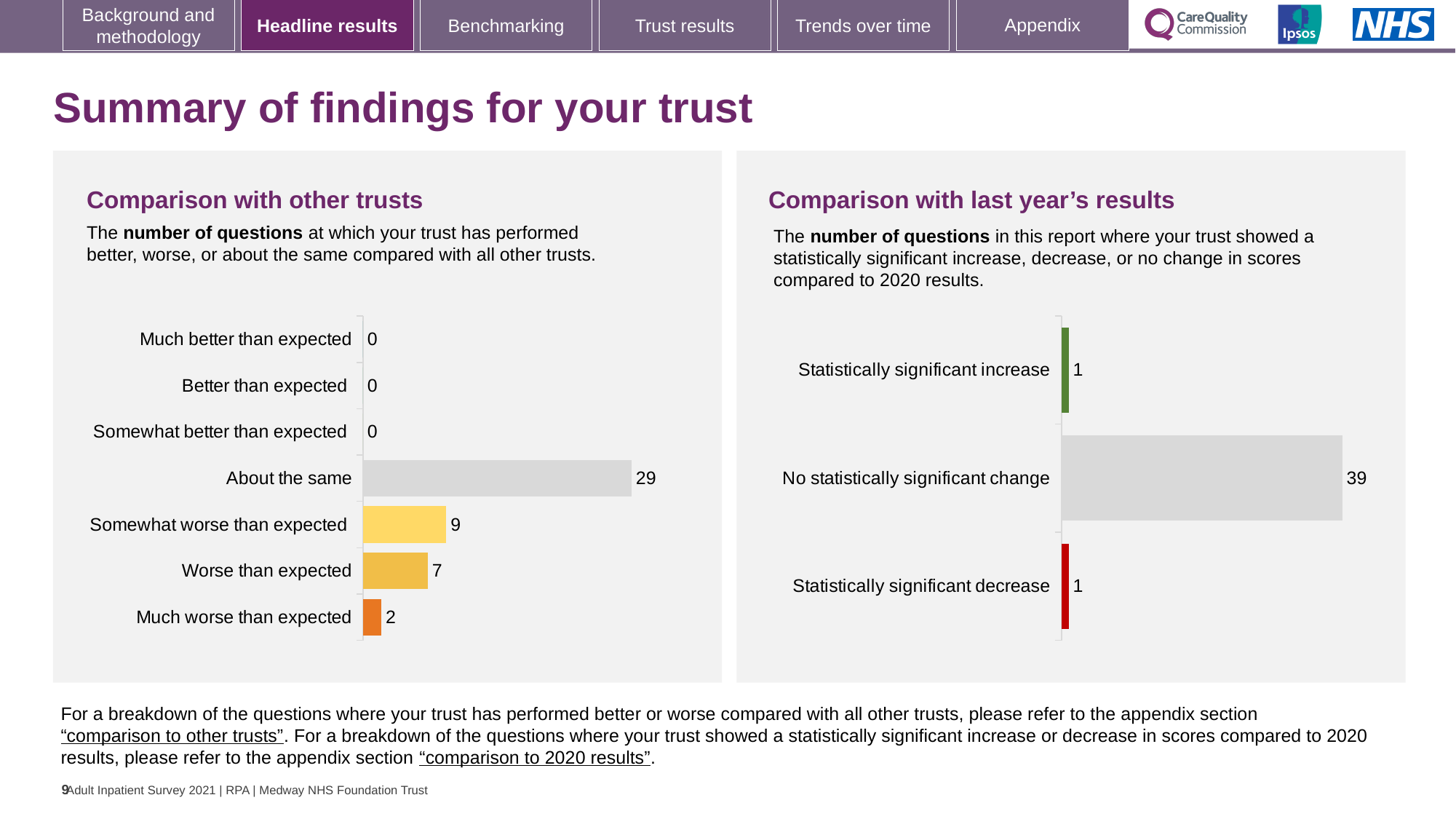
In the 'Comparison with other trusts' chart, how many questions are 'About the same'? 29 In the 'Comparison with last year's results' chart, what colour is the bar for 'Statistically significant decrease'? Red In the 'Comparison with other trusts' chart, what is the value for 'Much worse than expected'? 2 In the 'Comparison with other trusts' chart, how many categories have a value of 0? 3 In the 'Comparison with last year's results' chart, what is the value for 'No statistically significant change'? 39 In the 'Comparison with last year's results' chart, what is the value for 'Statistically significant increase'? 1 In the 'Comparison with other trusts' chart, how many categories are shown? 7 In the 'Comparison with other trusts' chart, what is the difference between 'Somewhat worse than expected' and 'Worse than expected'? 2 In the 'Comparison with other trusts' chart, what is the value for 'Somewhat worse than expected'? 9 In the 'Comparison with other trusts' chart, which category has the highest value? About the same What type of chart is the 'Comparison with last year's results' chart? Bar chart In the 'Comparison with last year's results' chart, what is the difference between 'No statistically significant change' and 'Statistically significant decrease'? 38